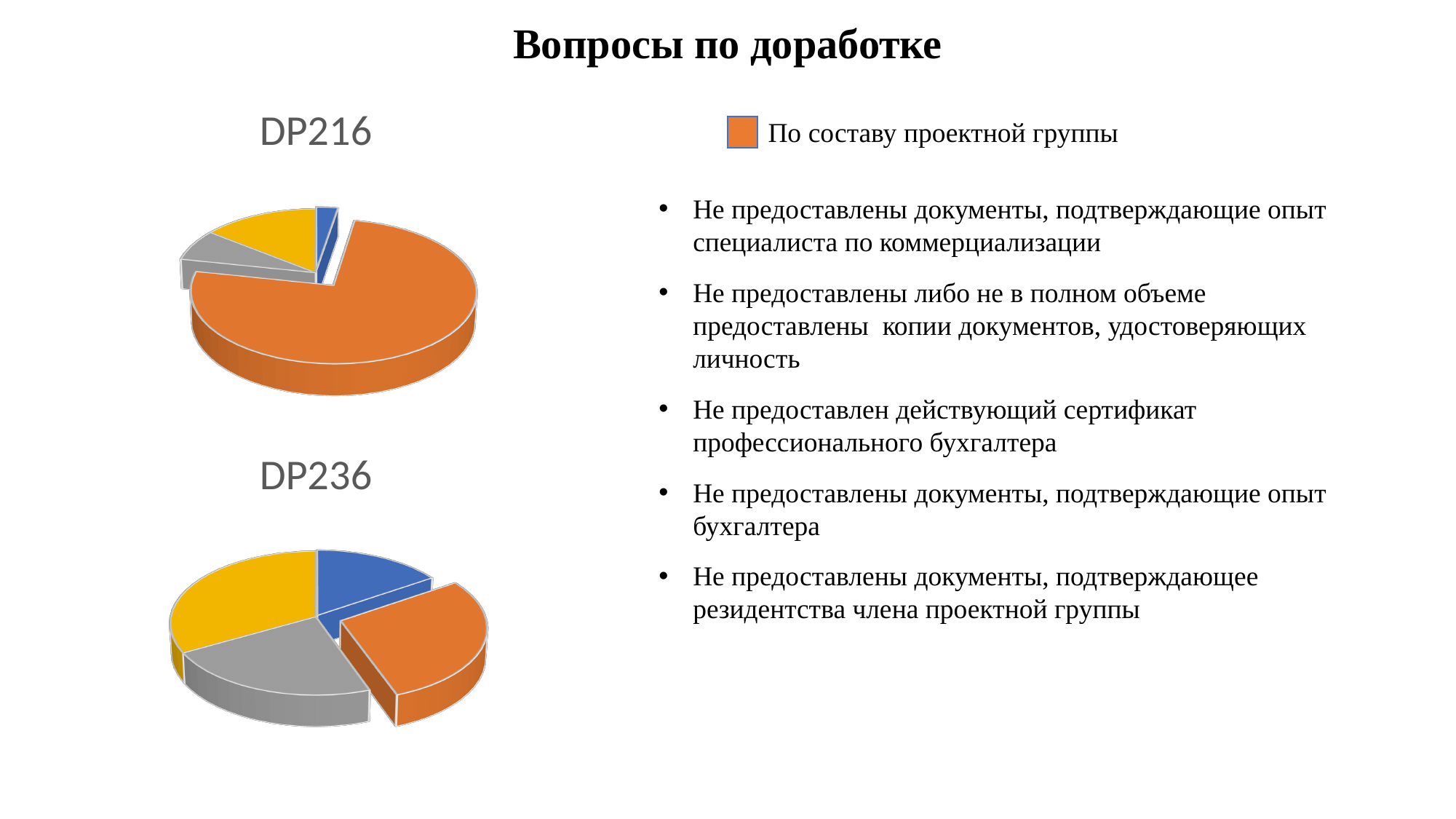
In the DP216 pie chart, which slice is larger, the orange one or the yellow one? orange In the DP216 pie chart, which colour slice is the smallest? blue In the DP236 pie chart, which slice is larger, the blue one or the gray one? gray What category does the orange legend swatch on the slide represent? По составу проектной группы What kind of chart is the DP236 chart? pie chart How many slices does the DP216 pie chart have? 4 What kind of chart is the DP216 chart? pie chart In the DP236 pie chart, which slice is larger, the orange one or the blue one? orange In the DP216 pie chart, which colour slice is the largest? orange In the DP236 pie chart, which colour slice is the smallest? blue What are the titles of the two pie charts on the slide? DP216 and DP236 How many slices does the DP236 pie chart have? 4